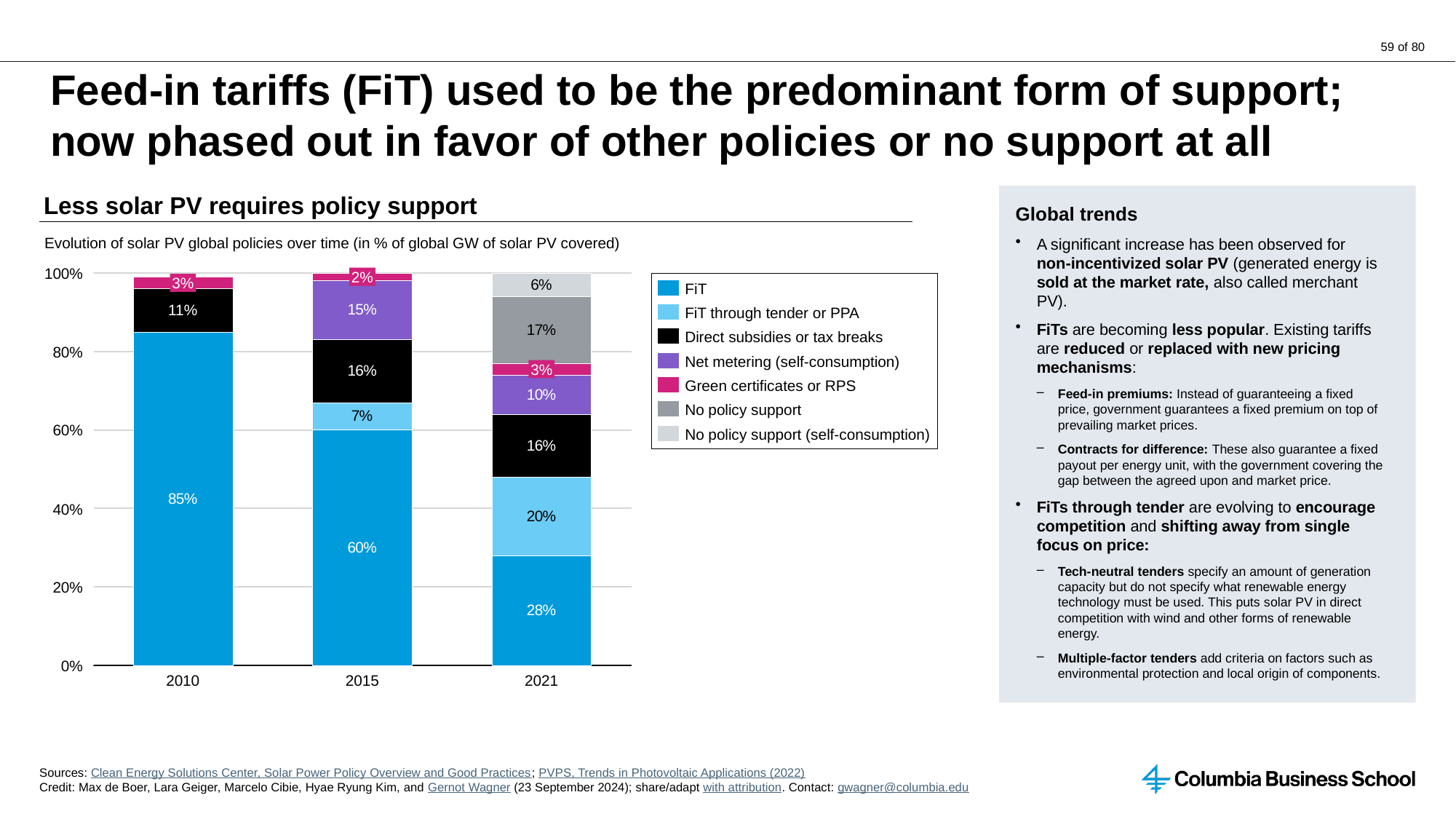
What is the value for FiT through tender or PPA in 2021? 20% In which year is the FiT share the highest? 2010 By how many percentage points did the FiT share fall from 2010 to 2021? 57% What share of global solar PV GW was covered by FiT in 2010? 85% What is the value for No policy support in 2021? 17% What kind of chart is shown? Stacked bar chart How many series does the legend list? 7 In which year is the FiT share the lowest? 2021 What is the value for Net metering (self-consumption) in 2015? 15% Which is larger in 2021: Direct subsidies or tax breaks, or Net metering (self-consumption)? Direct subsidies or tax breaks How many years are shown on the x axis? 3 Does the FiT share rise or fall from 2010 to 2021? Fall